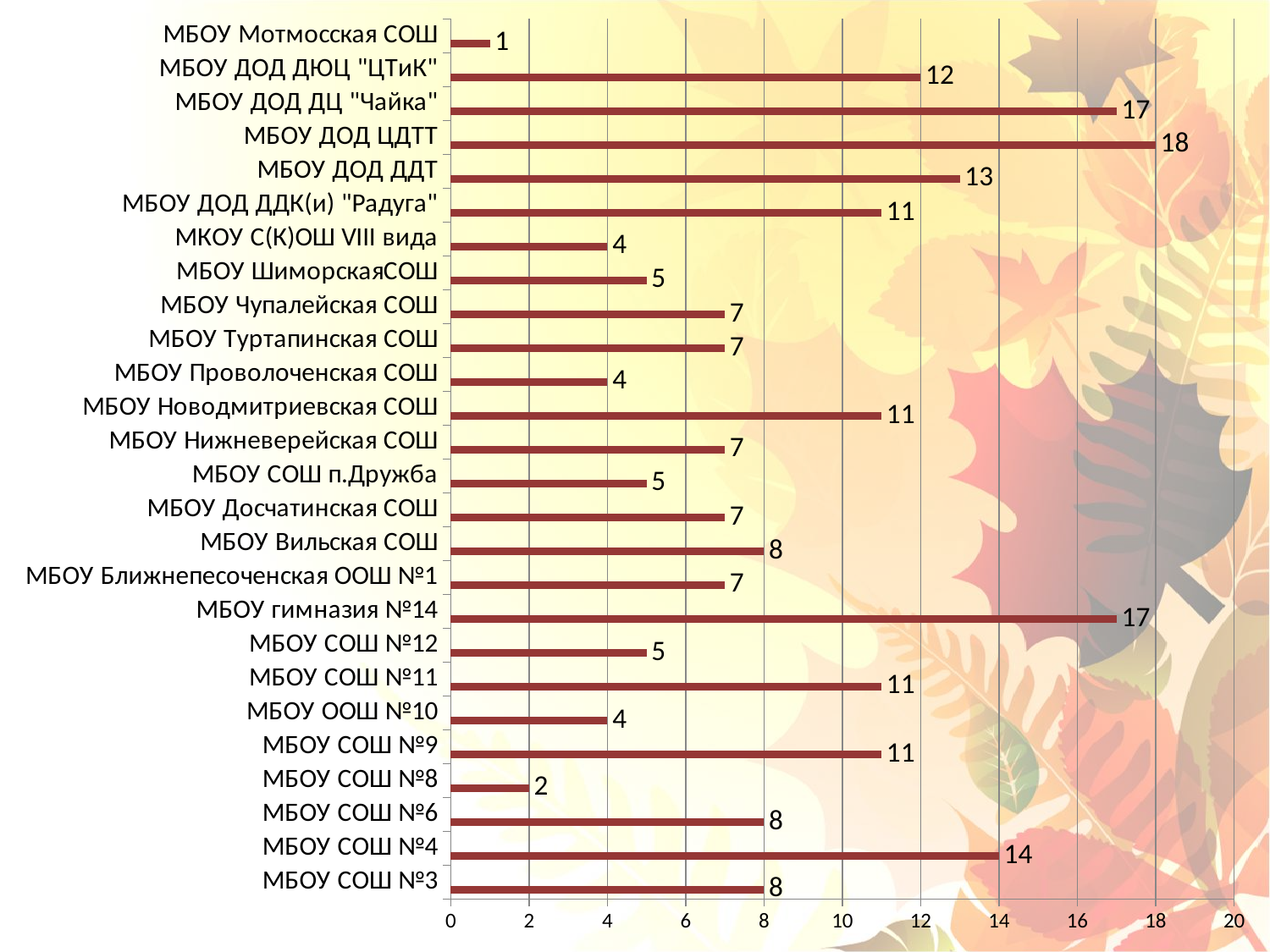
Which is larger, the value for МБОУ ДОД ДЮЦ "ЦТиК" or the value for МБОУ СОШ №11? МБОУ ДОД ДЮЦ "ЦТиК" What is the value for МБОУ СОШ №8? 2 What is the difference between the values for МБОУ СОШ №4 and МБОУ СОШ №3? 6 Which category has the lowest value? МБОУ Мотмосская СОШ Is the value for МБОУ ДОД ДЦ "Чайка" greater or less than 10? greater What is the value for МБОУ СОШ №4? 14 Which category has the highest value? МБОУ ДОД ЦДТТ How many categories are shown on the chart? 26 What is the value for МБОУ гимназия №14? 17 What is the difference between the values for МБОУ ДОД ЦДТТ and МБОУ ДОД ДДТ? 5 What is the value for МБОУ ДОД ЦДТТ? 18 What kind of chart is shown on the slide? bar chart